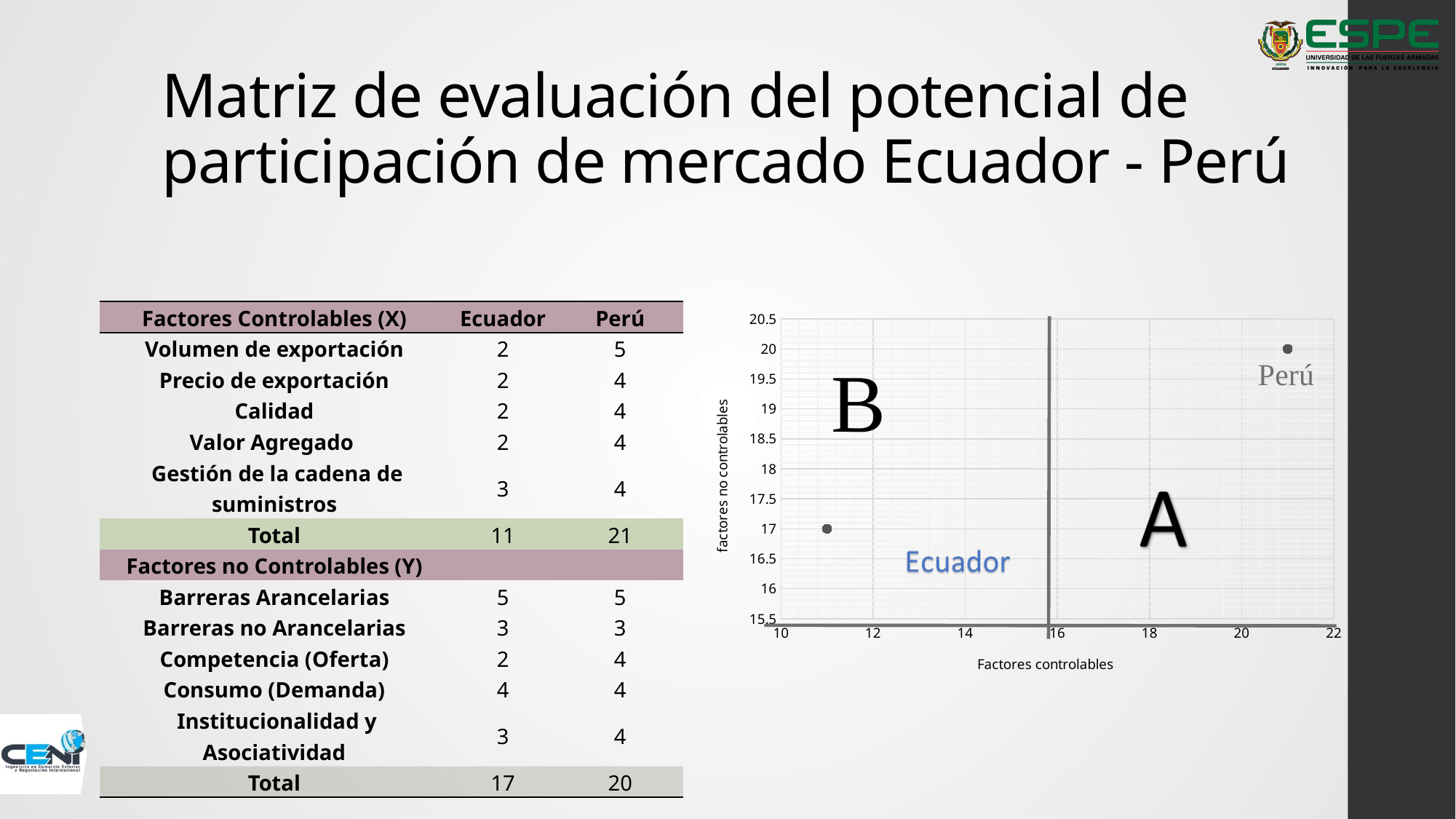
In the scatter chart, what is the 'factores no controlables' (y-axis) value for Perú? 20 In the scatter chart, is the 'Factores controlables' value for Ecuador greater or less than 12? less In the scatter chart, is the 'Factores controlables' value for Perú greater or less than 20? greater In the scatter chart, which point has the highest 'Factores controlables' value? Perú What is the title of the x axis of the scatter chart? Factores controlables In the scatter chart, what is the difference between the 'factores no controlables' values of Perú and Ecuador? 3 In the scatter chart, which point has the lowest 'factores no controlables' value? Ecuador In which labelled quadrant of the scatter chart does the Perú point fall? A In the scatter chart, what is the 'factores no controlables' (y-axis) value for Ecuador? 17 What kind of chart is shown on the right of the slide? scatter chart How many data points are plotted in the scatter chart? 2 In the scatter chart, which point has the higher 'factores no controlables' value, Ecuador or Perú? Perú